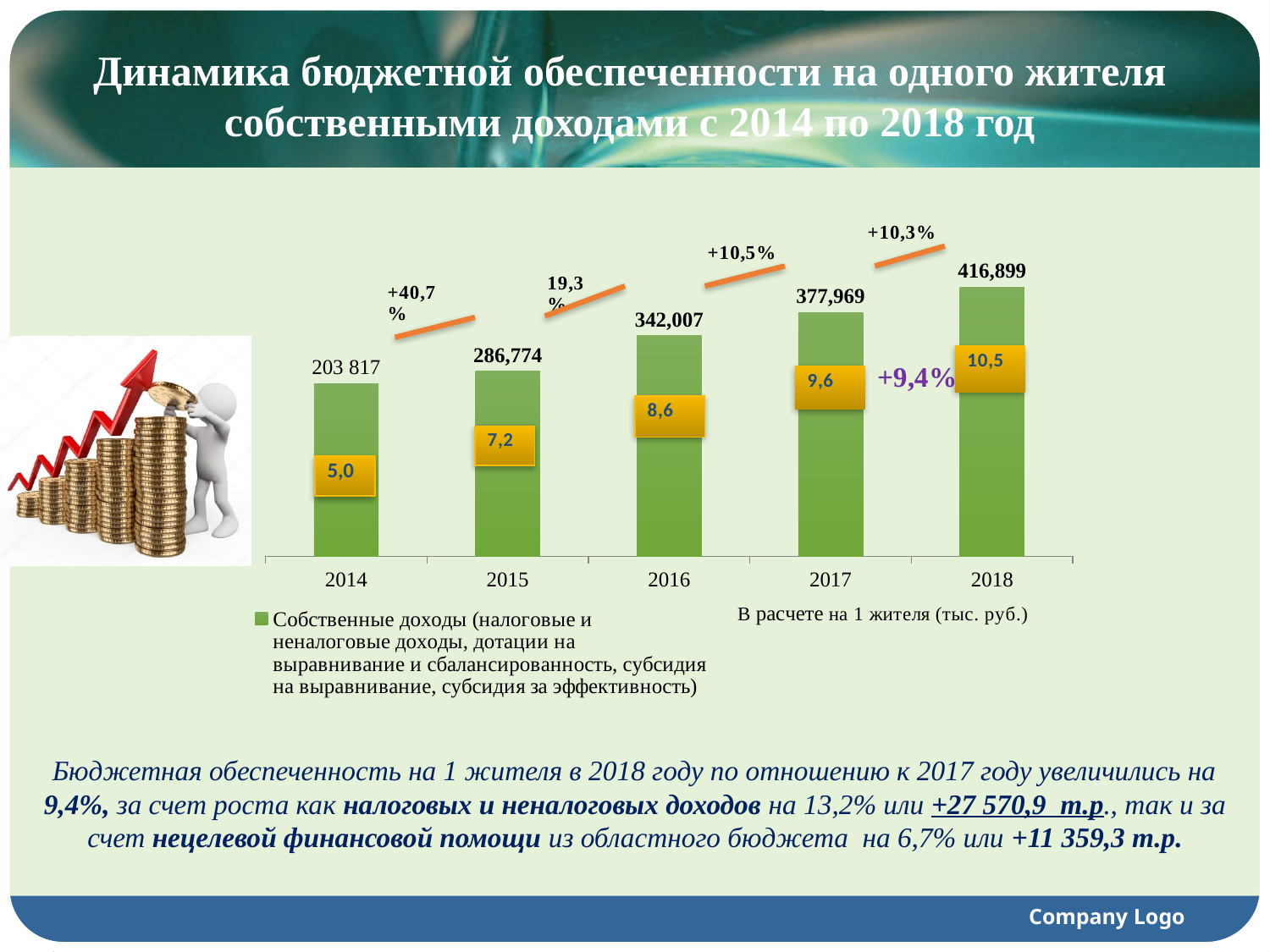
What percentage growth is shown between 2017 and 2018 in the purple label? +9,4% Which year has the highest value? 2018 What is the value for 2018? 416,899 Which is larger, the value for 2015 or the value for 2016? 2016 What is the value for 2016? 342,007 What is the value for 2014? 203 817 Do the values rise or fall from 2014 to 2018? rise Which year has the lowest value? 2014 What kind of chart is shown on the slide? bar chart How many series does the legend list? 1 How many years are shown on the x axis? 5 What is the difference between the values for 2018 and 2017? 38,930